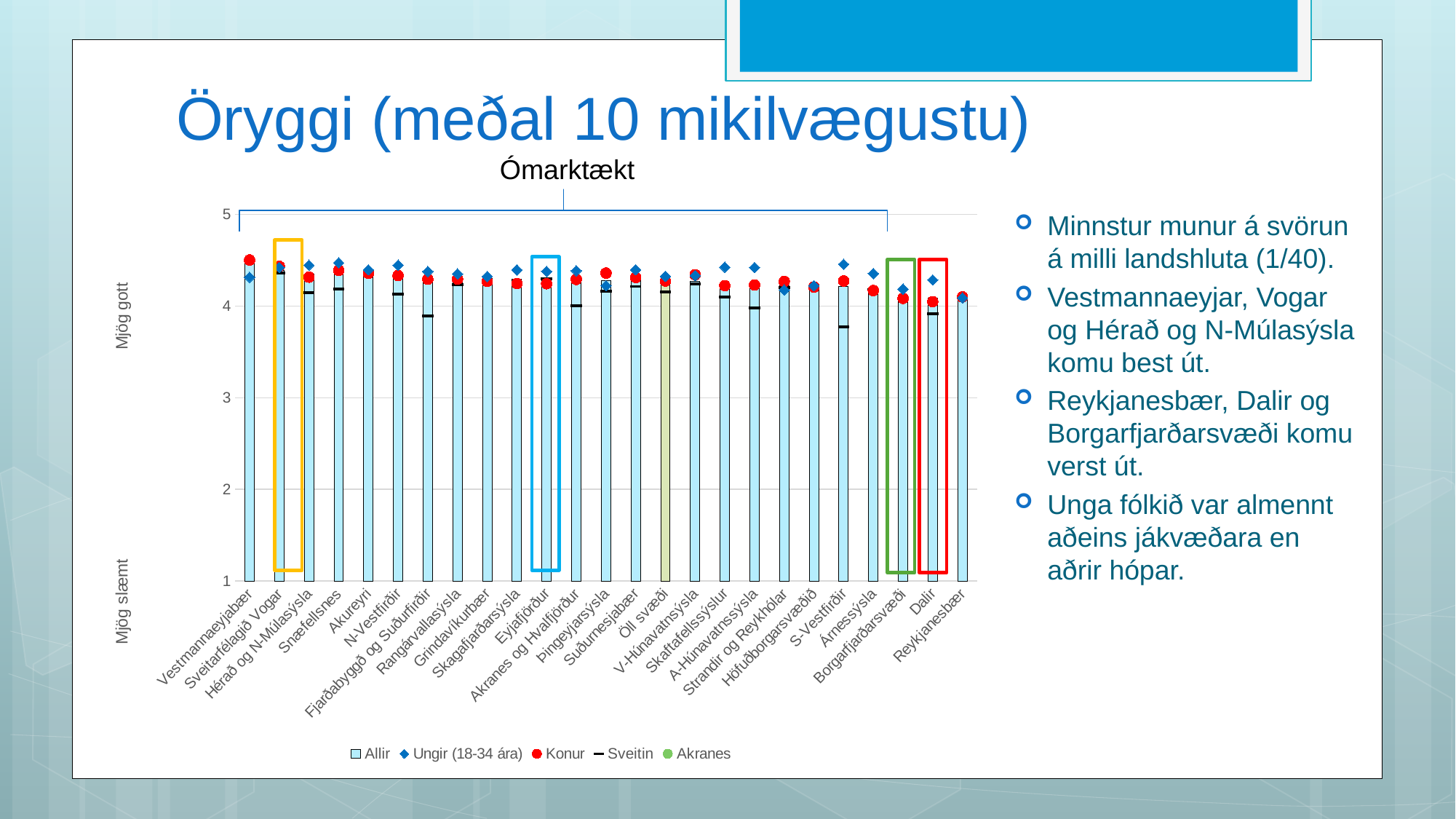
Is the Sveitin value for S-Vestfirðir greater or less than 4? less What is the first series listed in the chart legend? Allir What kind of chart is shown on the slide? bar chart What label appears at the top of the y axis of the chart? Mjög gott Which category has the lowest Allir bar in the chart? Reykjanesbær How many series does the chart legend list? 5 Which has the larger Allir bar, Vestmannaeyjabær or Reykjanesbær? Vestmannaeyjabær Is the Allir value for Vestmannaeyjabær greater or less than 4? greater Which category has the highest Allir bar in the chart? Vestmannaeyjabær Do the Allir bars generally rise or fall from left to right along the x axis? fall Is the Allir value for Reykjanesbær greater or less than 3? greater How many categories are shown along the x axis of the chart? 25